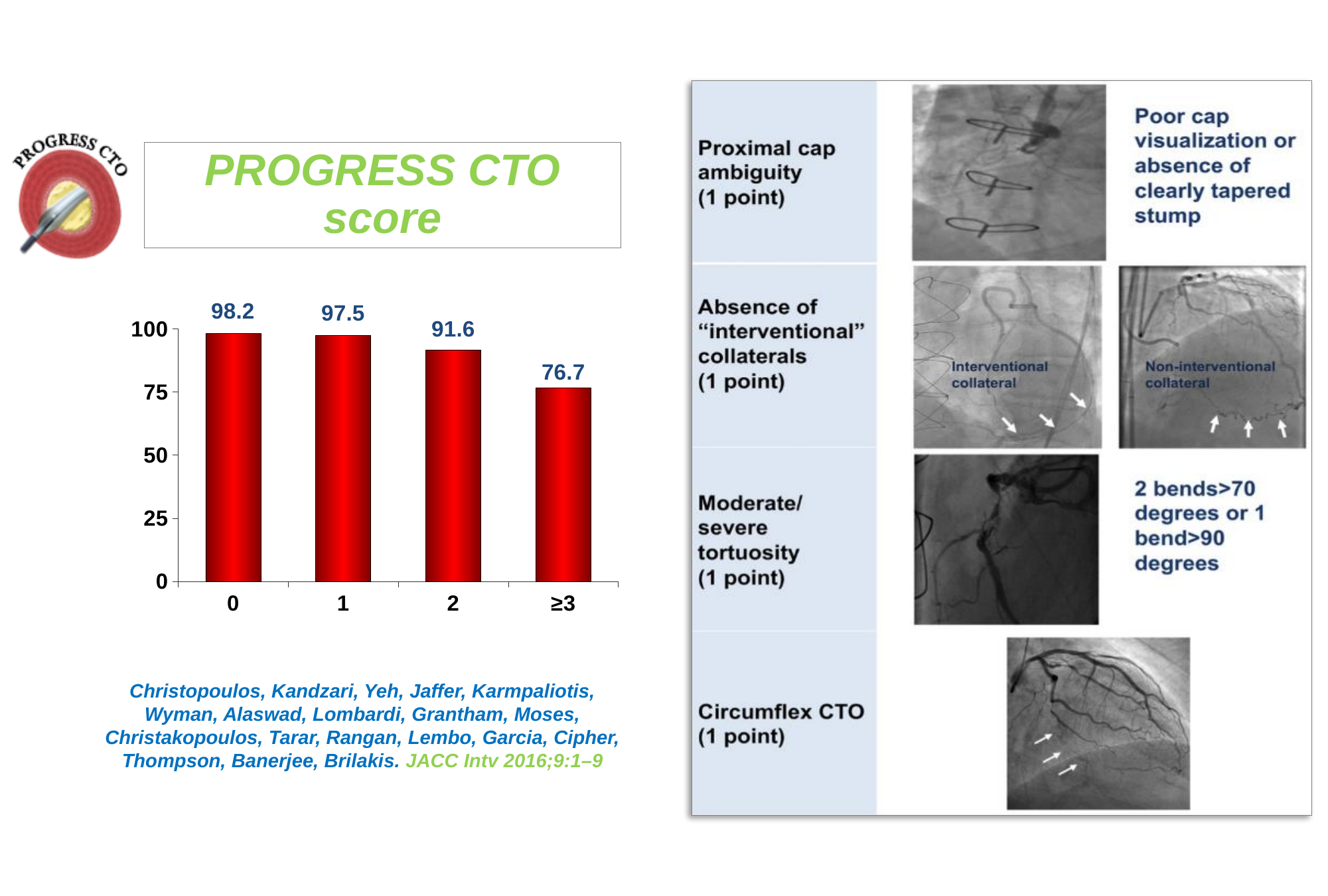
Which is larger, the value for score 2 or the value for score ≥3? 2 Do the values rise or fall as the score increases along the x axis? fall What is the value for the score category 2? 91.6 What is the difference between the values for score 2 and score ≥3? 14.9 How many score categories are shown on the x axis? 4 Which score category has the highest value? 0 What is the value for the score category 0? 98.2 What is the value for the score category 1? 97.5 What is the difference between the values for score 0 and score ≥3? 21.5 What kind of chart is shown on the slide? bar chart What is the value for the score category ≥3? 76.7 Which score category has the lowest value? ≥3